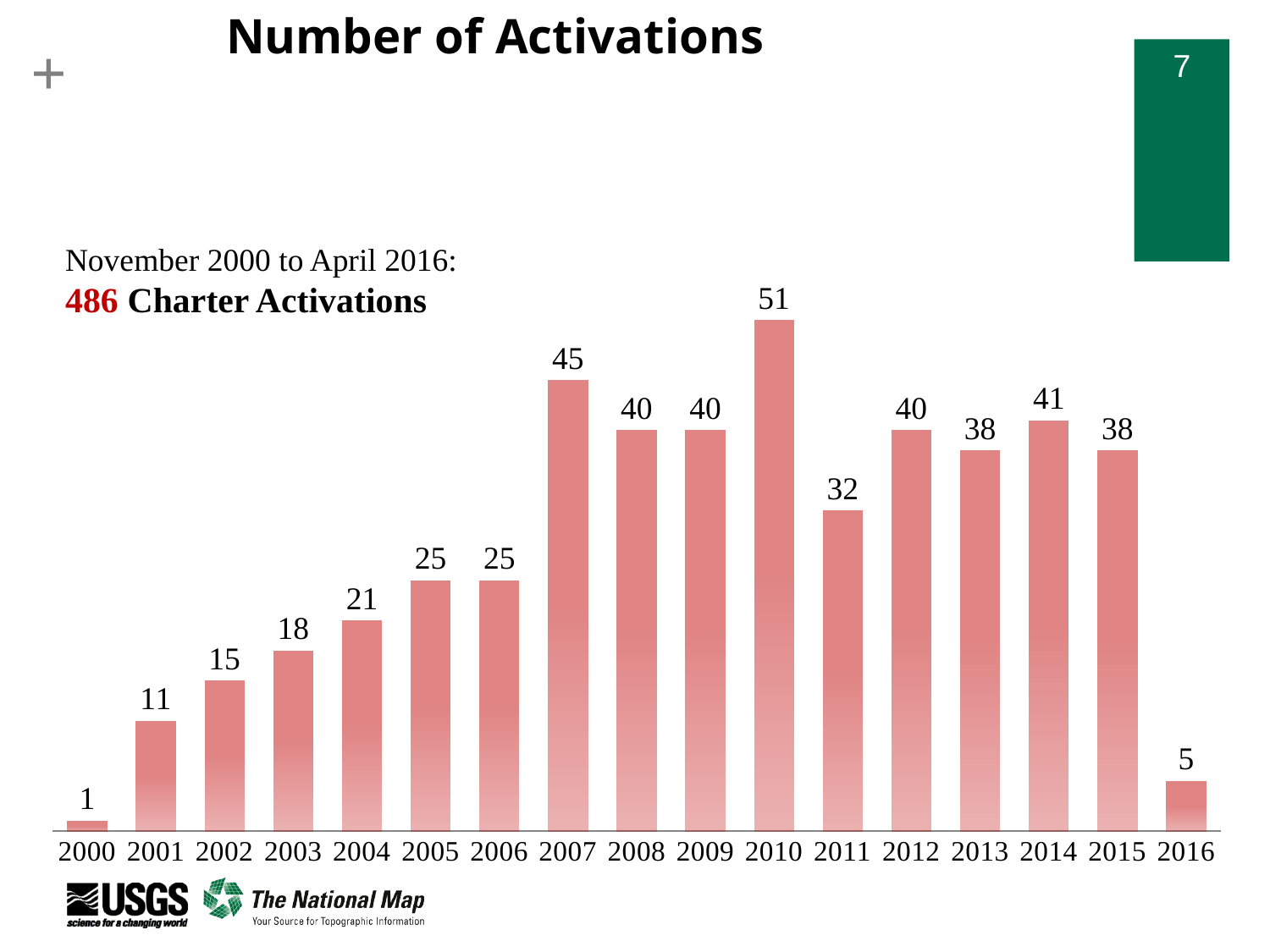
What is the number of activations for 2003? 18 How many years are shown on the x axis of the chart? 17 Do the number of activations rise or fall from 2000 to 2007? rise What is the difference between the number of activations in 2010 and 2011? 19 Which year has more activations, 2002 or 2005? 2005 Which year has the lowest number of activations? 2000 What is the number of activations for 2010? 51 What kind of chart is shown on the slide? bar chart Which year has the highest number of activations? 2010 Which year has more activations, 2014 or 2013? 2014 What is the number of activations for 2016? 5 What is the difference between the number of activations in 2007 and 2004? 24